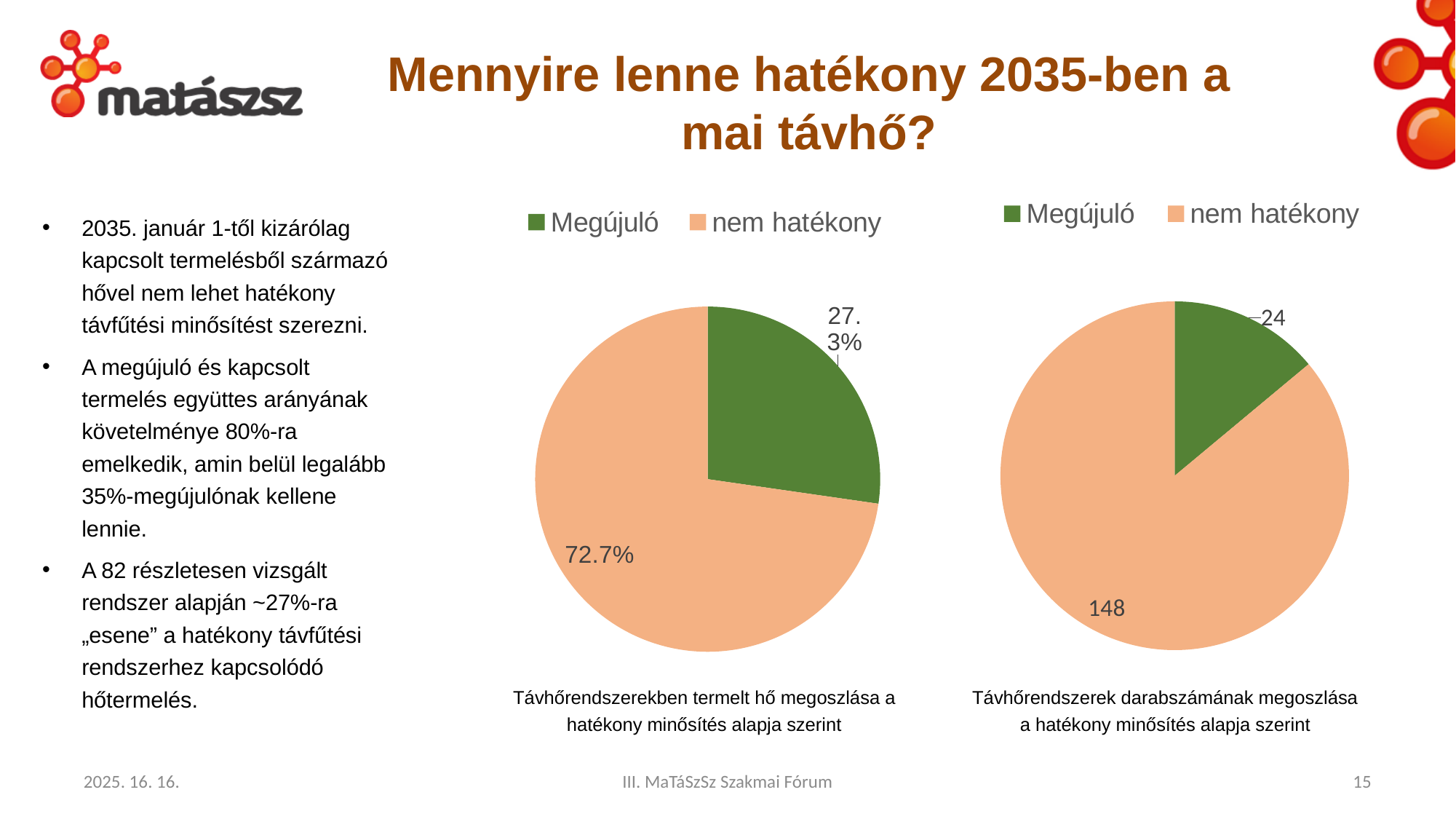
How many series does the legend of the left pie chart list? 2 In the right pie chart (Távhőrendszerek darabszámának megoszlása), what colour is the Megújuló slice? Green What type of chart is the chart on the right of the slide? Pie chart In the right pie chart (Távhőrendszerek darabszámának megoszlása), what value is shown for Megújuló? 24 In the right pie chart (Távhőrendszerek darabszámának megoszlása), what value is shown for nem hatékony? 148 In the left pie chart (Távhőrendszerekben termelt hő megoszlása), which category has the smallest slice? Megújuló In the right pie chart (Távhőrendszerek darabszámának megoszlása), which category has the largest slice? nem hatékony In the right pie chart (Távhőrendszerek darabszámának megoszlása), what is the total of the two slices? 172 In the right pie chart (Távhőrendszerek darabszámának megoszlása), what is the difference between the nem hatékony and Megújuló values? 124 In the left pie chart (Távhőrendszerekben termelt hő megoszlása), which is larger: Megújuló or nem hatékony? nem hatékony In the left pie chart (Távhőrendszerekben termelt hő megoszlása), what percentage is shown for Megújuló? 27.3% In the left pie chart (Távhőrendszerekben termelt hő megoszlása), what percentage is shown for nem hatékony? 72.7%